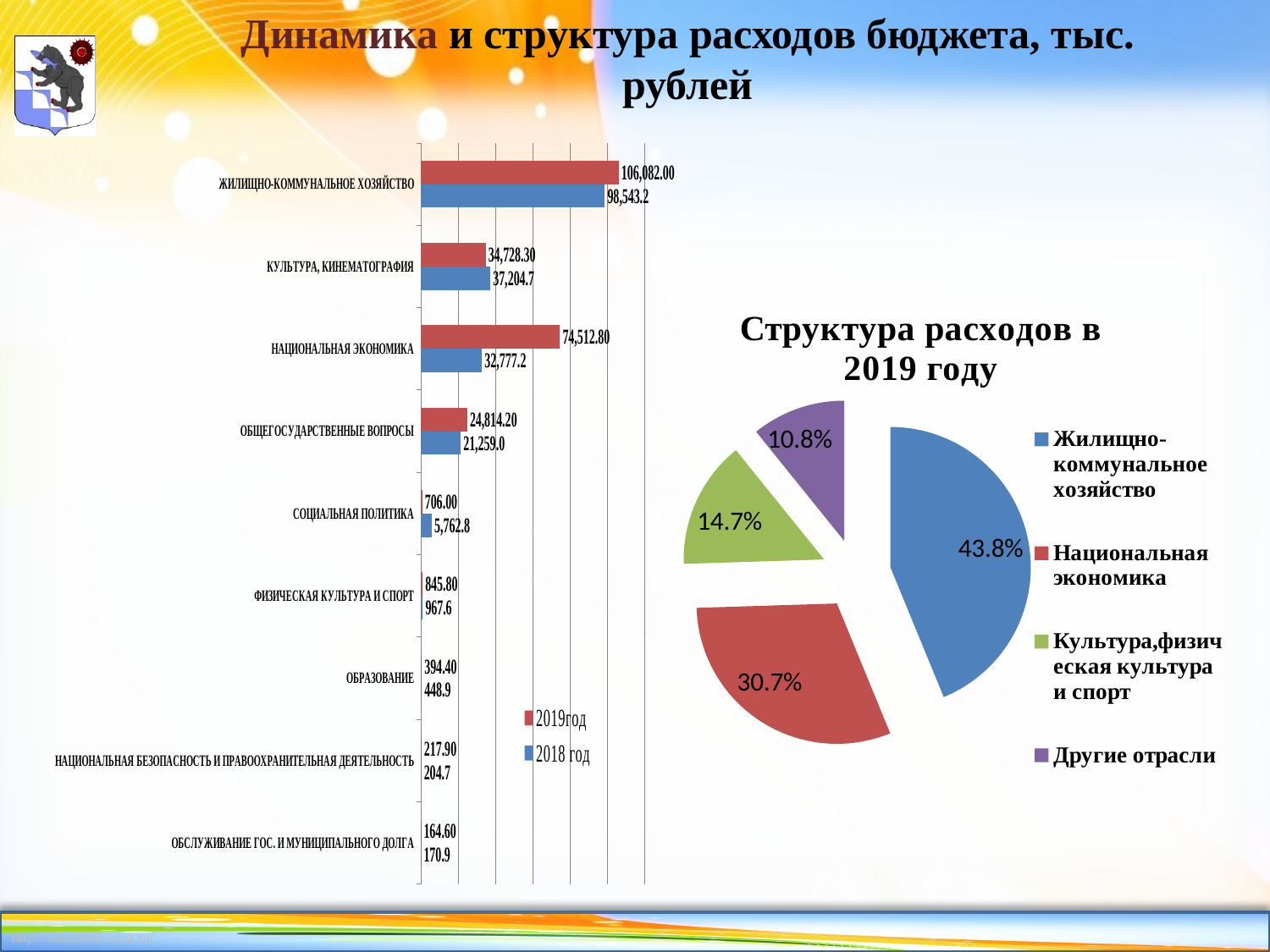
In the bar chart on the left, which category has the lowest 2019 value? ОБСЛУЖИВАНИЕ ГОС. И МУНИЦИПАЛЬНОГО ДОЛГА In the bar chart on the left, what is the difference between the 2019 and 2018 values for НАЦИОНАЛЬНАЯ ЭКОНОМИКА? 41,735.6 How many series does the legend of the bar chart on the left list? 2 How many categories does the bar chart on the left show? 9 In the bar chart on the left, what is the 2019 value for ЖИЛИЩНО-КОММУНАЛЬНОЕ ХОЗЯЙСТВО? 106,082.00 In the bar chart on the left, what is the 2018 value for НАЦИОНАЛЬНАЯ ЭКОНОМИКА? 32,777.2 In the bar chart on the left, what is the 2018 value for СОЦИАЛЬНАЯ ПОЛИТИКА? 5,762.8 In the pie chart 'Структура расходов в 2019 году', which category has the largest slice? Жилищно-коммунальное хозяйство What type of chart is the chart on the right of the slide? Pie chart In the bar chart on the left, which is larger for КУЛЬТУРА, КИНЕМАТОГРАФИЯ: the 2019 value or the 2018 value? 2018 In the pie chart 'Структура расходов в 2019 году', what share does Национальная экономика have? 30.7% In the bar chart on the left, which category has the highest 2019 value? ЖИЛИЩНО-КОММУНАЛЬНОЕ ХОЗЯЙСТВО